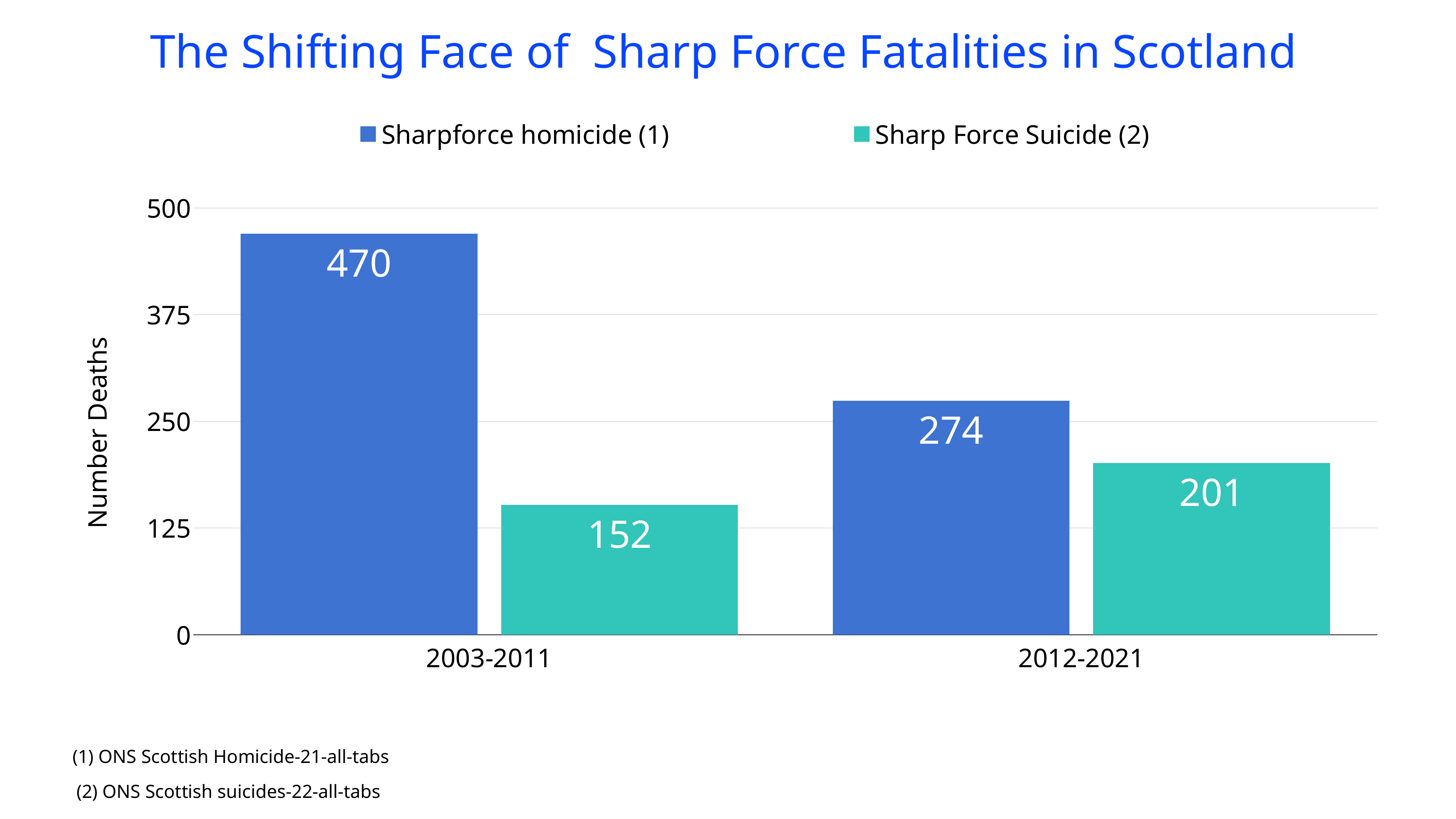
Which period has the lowest value for Sharp Force Suicide (2)? 2003-2011 What is the value for Sharp Force Suicide (2) in 2003-2011? 152 What kind of chart is shown on the slide? Bar chart How many periods are shown on the x axis? 2 What is the value for Sharpforce homicide (1) in 2003-2011? 470 What is the value for Sharp Force Suicide (2) in 2012-2021? 201 What is the difference between Sharpforce homicide (1) in 2003-2011 and in 2012-2021? 196 How many series does the legend list? 2 Which is larger in 2012-2021: Sharpforce homicide (1) or Sharp Force Suicide (2)? Sharpforce homicide (1) What is the value for Sharpforce homicide (1) in 2012-2021? 274 Does the value for Sharp Force Suicide (2) rise or fall from 2003-2011 to 2012-2021? Rise Which period has the highest value for Sharpforce homicide (1)? 2003-2011